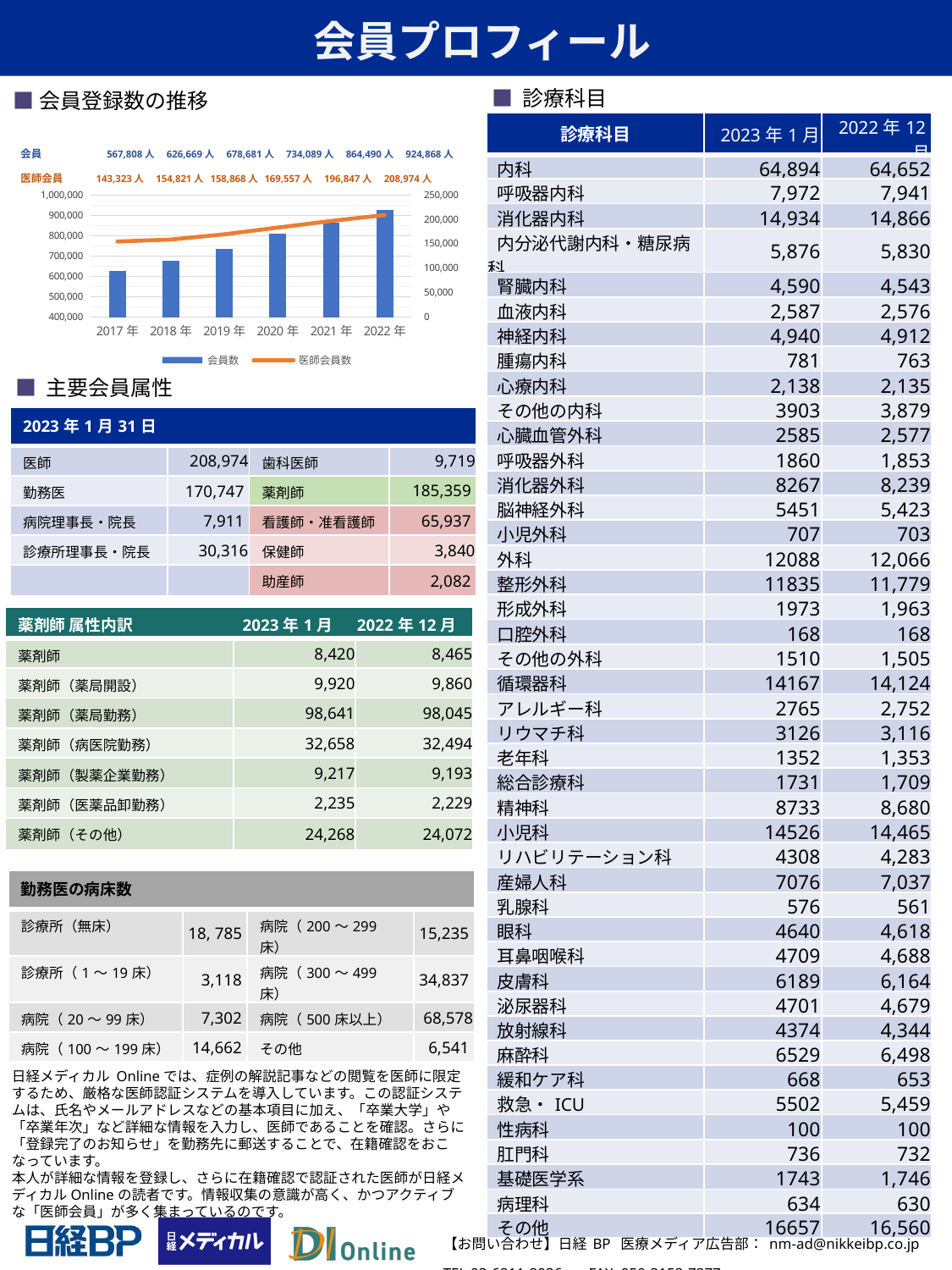
In the 会員登録数の推移 chart, which year has the lowest 医師会員 value? 2017年 In the 会員登録数の推移 chart, which is larger: the 会員 value for 2019年 or for 2020年? 2020年 In the 会員登録数の推移 chart, how many years are shown on the x axis? 6 In the 会員登録数の推移 chart, which series is drawn as a line? 医師会員数 In the 会員登録数の推移 chart, what is the 会員 value for 2022年? 924,868人 In the 会員登録数の推移 chart, do the 会員 values rise or fall from 2017年 to 2022年? rise In the 会員登録数の推移 chart, what is the difference between the 会員 values for 2022年 and 2021年? 60,378人 How many series does the legend of the 会員登録数の推移 chart list? 2 In the 会員登録数の推移 chart, which year has the highest 会員 value? 2022年